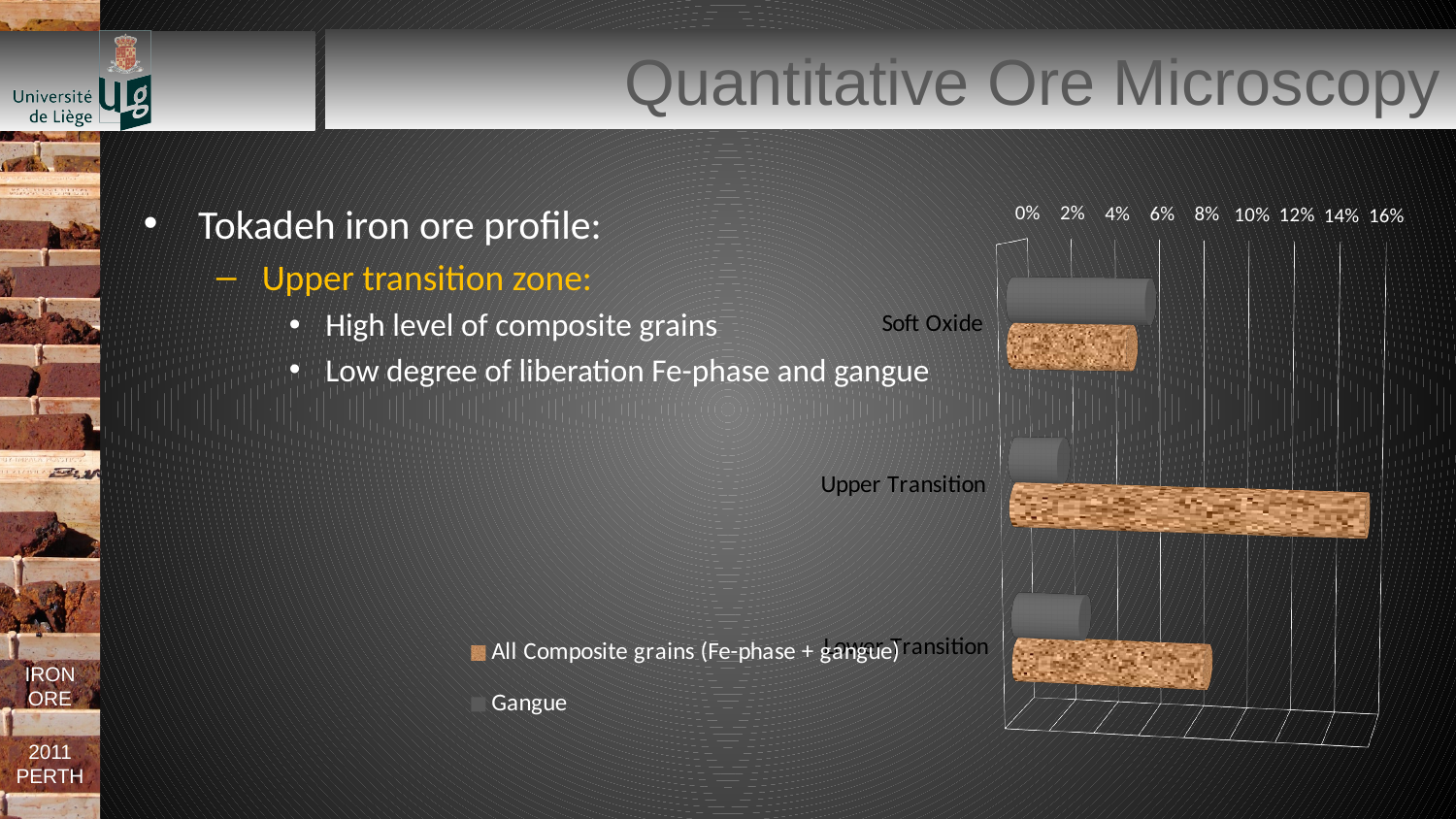
Is the Gangue value for Upper Transition greater or less than 4%? less How many categories are plotted on the chart? 3 Is the All Composite grains value for Lower Transition greater or less than 6%? greater Which is larger: the All Composite grains value for Upper Transition or for Lower Transition? Upper Transition Which category has the highest value for All Composite grains (Fe-phase + gangue)? Upper Transition Is the All Composite grains value for Upper Transition greater or less than 14%? greater What is the highest value shown on the chart's percentage axis? 16% What kind of chart is shown on the slide? bar chart How many series does the chart legend list? 2 Which is larger: the Gangue value for Soft Oxide or for Upper Transition? Soft Oxide Which category has the lowest value for All Composite grains (Fe-phase + gangue)? Soft Oxide